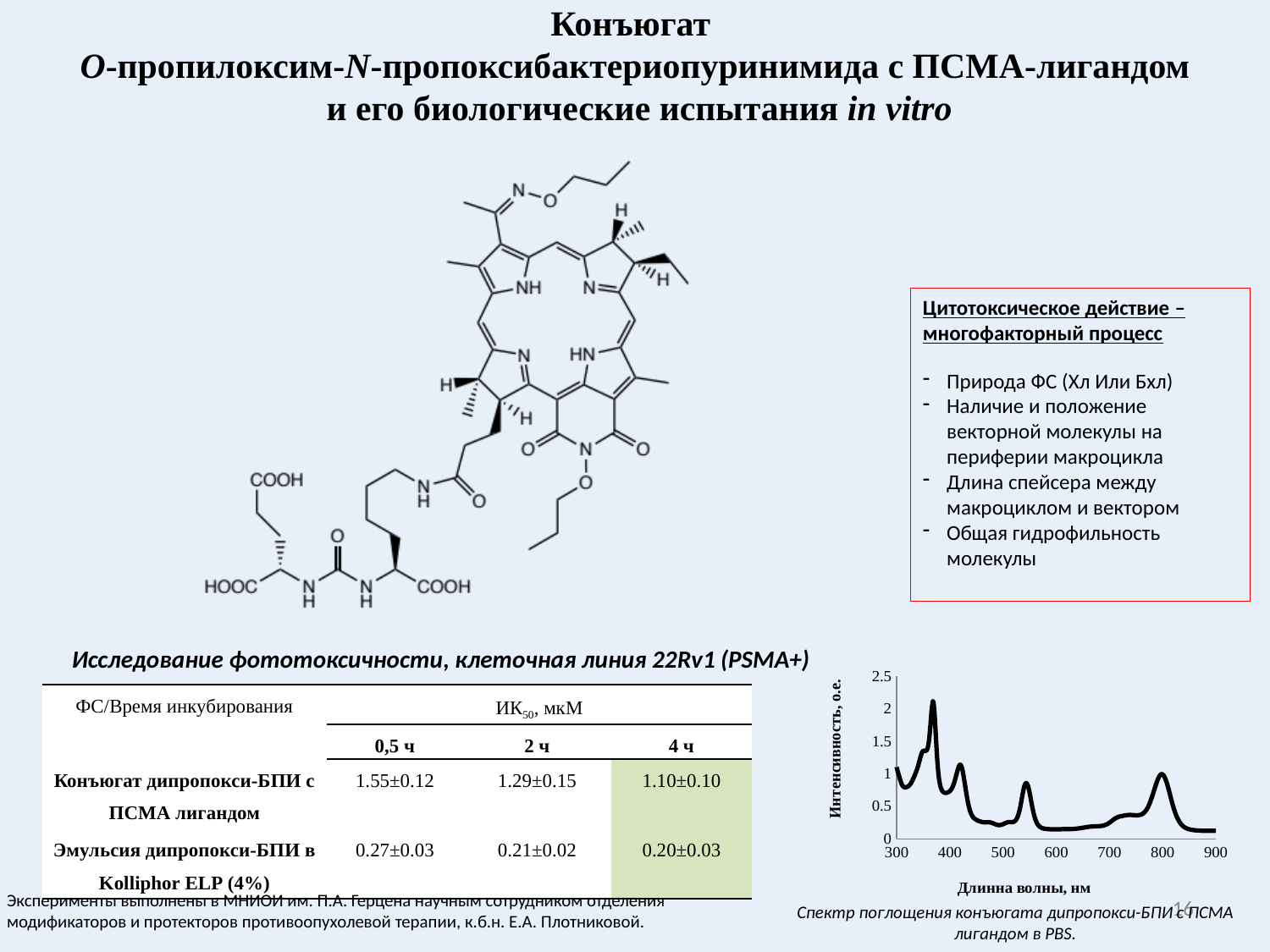
In the absorption spectrum chart, is the intensity at 700 nm greater or less than 0.5? less In the absorption spectrum chart, is the intensity at 600 nm greater or less than 0.5? less In the absorption spectrum chart, is the intensity of the peak near 540 nm greater or less than 1? less What is the label of the y axis of the absorption spectrum chart? Интенсивность, о.е. What is the maximum value shown on the x axis of the absorption spectrum chart? 900 What is the label of the x axis of the absorption spectrum chart? Длинна волны, нм In the absorption spectrum chart, which is larger: the peak near 370 nm or the peak near 800 nm? the peak near 370 nm What kind of chart is shown at the bottom right of the slide? line chart In the absorption spectrum chart, is the highest peak located below or above 500 nm? below